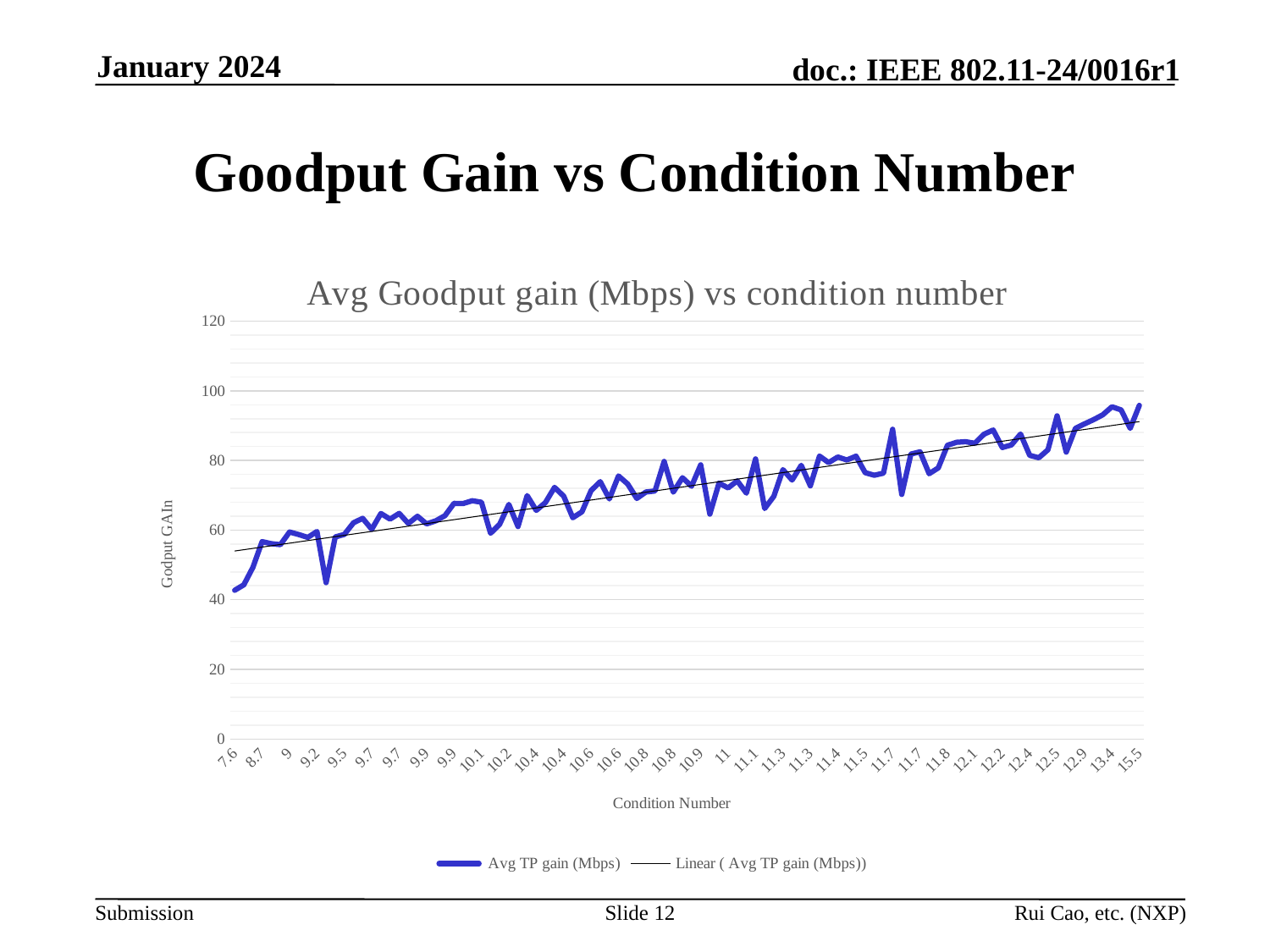
Is the Avg TP gain (Mbps) value at condition number 15.5 greater or less than 80? greater Is the Avg TP gain (Mbps) value at condition number 11 greater or less than 60? greater How many series does the chart legend list? 2 Do the Avg TP gain (Mbps) values generally rise or fall as the condition number increases along the x axis? rise Is the Avg TP gain (Mbps) value at condition number 8.7 greater or less than 80? less What is the title of the chart? Avg Goodput gain (Mbps) vs condition number Which has the larger Avg TP gain (Mbps) value: condition number 7.6 or condition number 15.5? 15.5 What kind of chart is shown on the slide? line chart Which has the larger Avg TP gain (Mbps) value: condition number 8.7 or condition number 12.5? 12.5 What is the label of the x axis? Condition Number